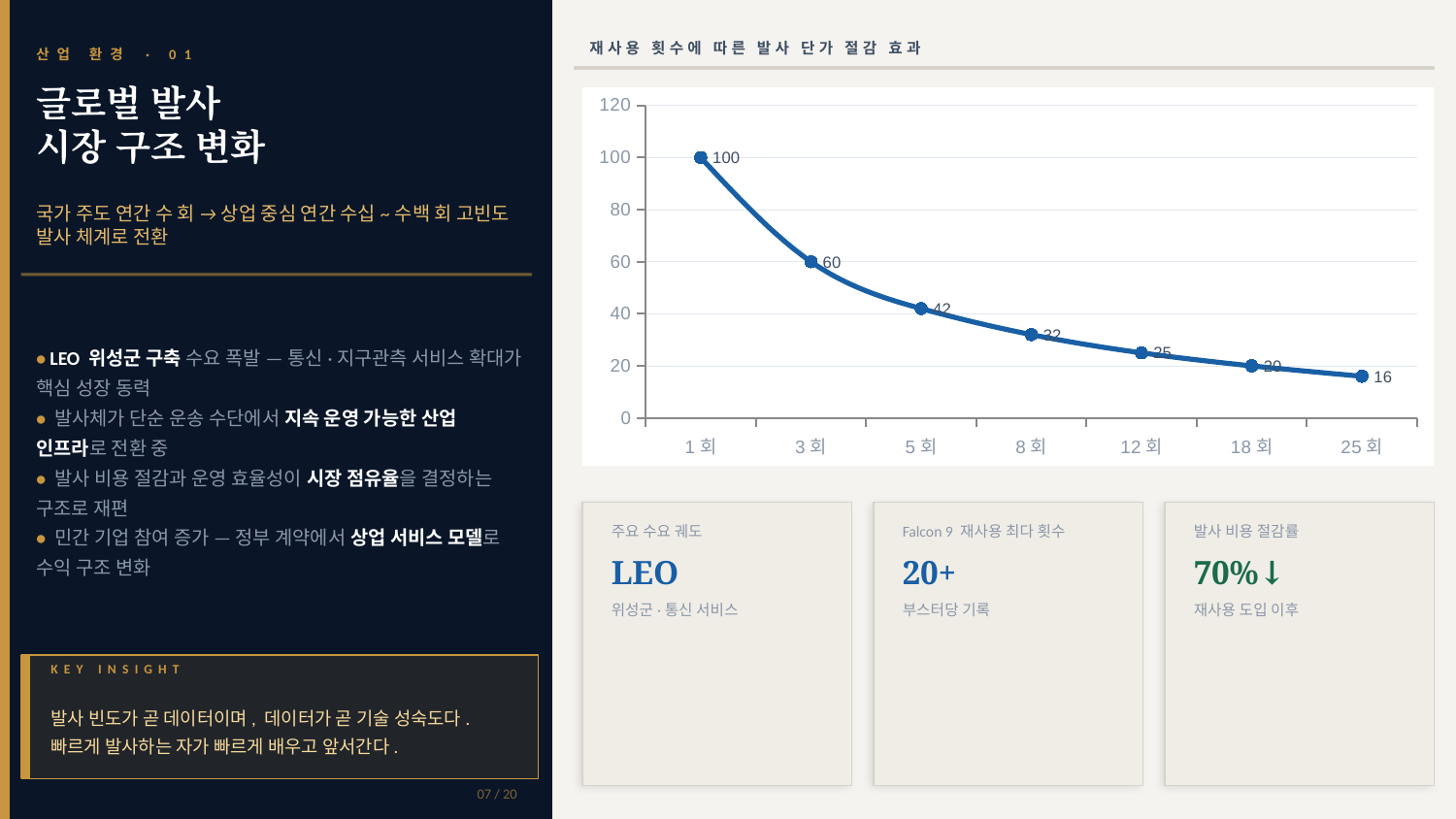
What is the value at 1 회? 100 What is the value at 3 회? 60 Is the value for 12 회 greater or less than 40? less What type of chart is shown on the slide? line chart How many data points are plotted on the chart? 7 What is the value at 5 회? 42 Which is larger, the value at 5 회 or the value at 25 회? 5 회 Which x-axis category has the lowest value? 25 회 What is the difference between the values at 1 회 and 3 회? 40 What is the value at 25 회? 16 What is the title of the chart? 재사용 횟수에 따른 발사 단가 절감 효과 Which x-axis category has the highest value? 1 회